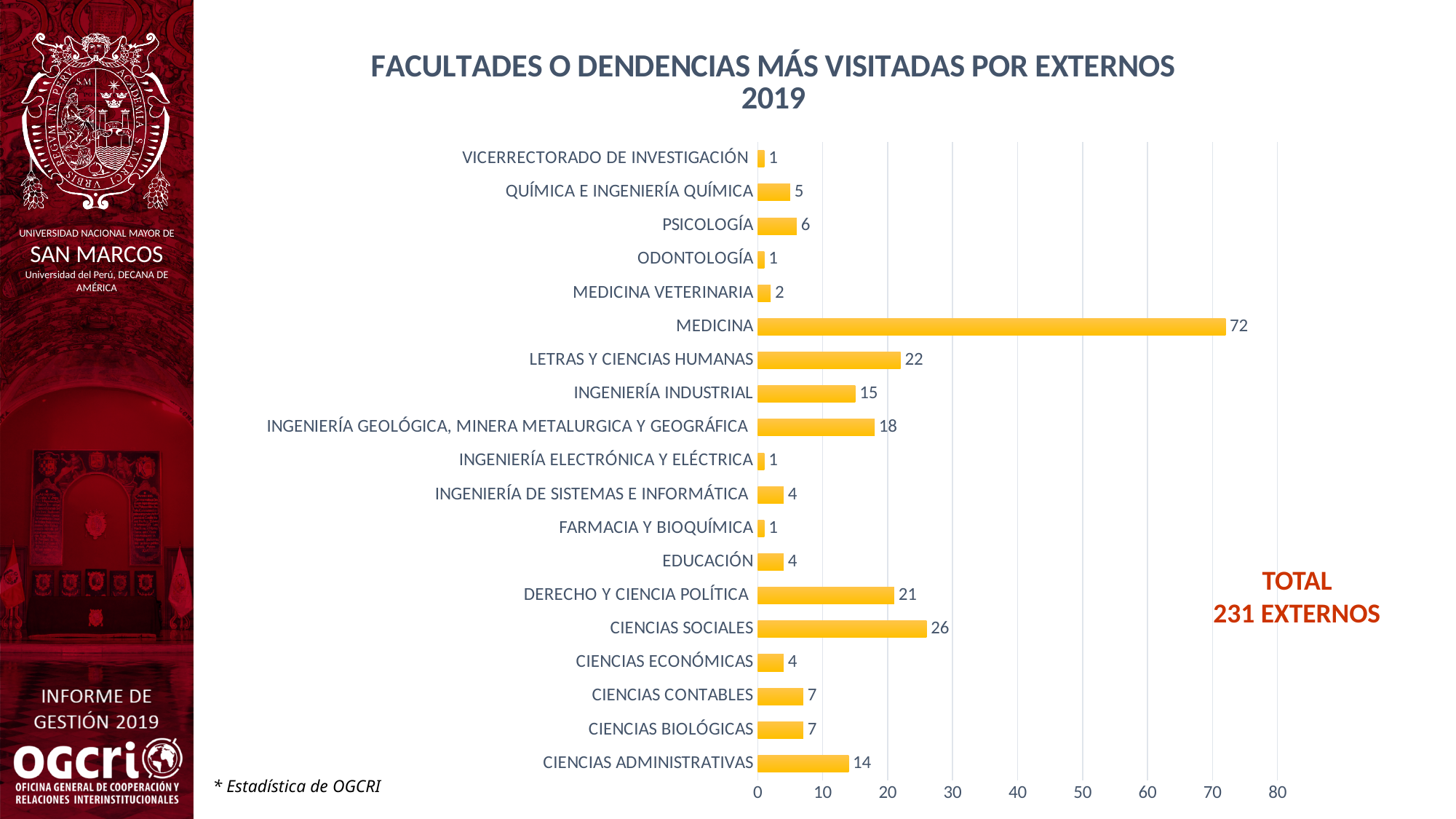
What is the value for INGENIERÍA GEOLÓGICA, MINERA METALURGICA Y GEOGRÁFICA? 18 Which category has the highest value? MEDICINA What is the value for MEDICINA? 72 Which is larger, the value for INGENIERÍA INDUSTRIAL or the value for CIENCIAS ADMINISTRATIVAS? INGENIERÍA INDUSTRIAL What is the title of the chart? FACULTADES O DENDENCIAS MÁS VISITADAS POR EXTERNOS 2019 What total is stated next to the chart? 231 EXTERNOS What kind of chart is shown on the slide? bar chart What is the value for CIENCIAS SOCIALES? 26 What is the difference between the values for LETRAS Y CIENCIAS HUMANAS and DERECHO Y CIENCIA POLÍTICA? 1 What is the difference between the values for MEDICINA and CIENCIAS SOCIALES? 46 Is the value for MEDICINA greater or less than 60? greater How many categories are shown in the chart? 19